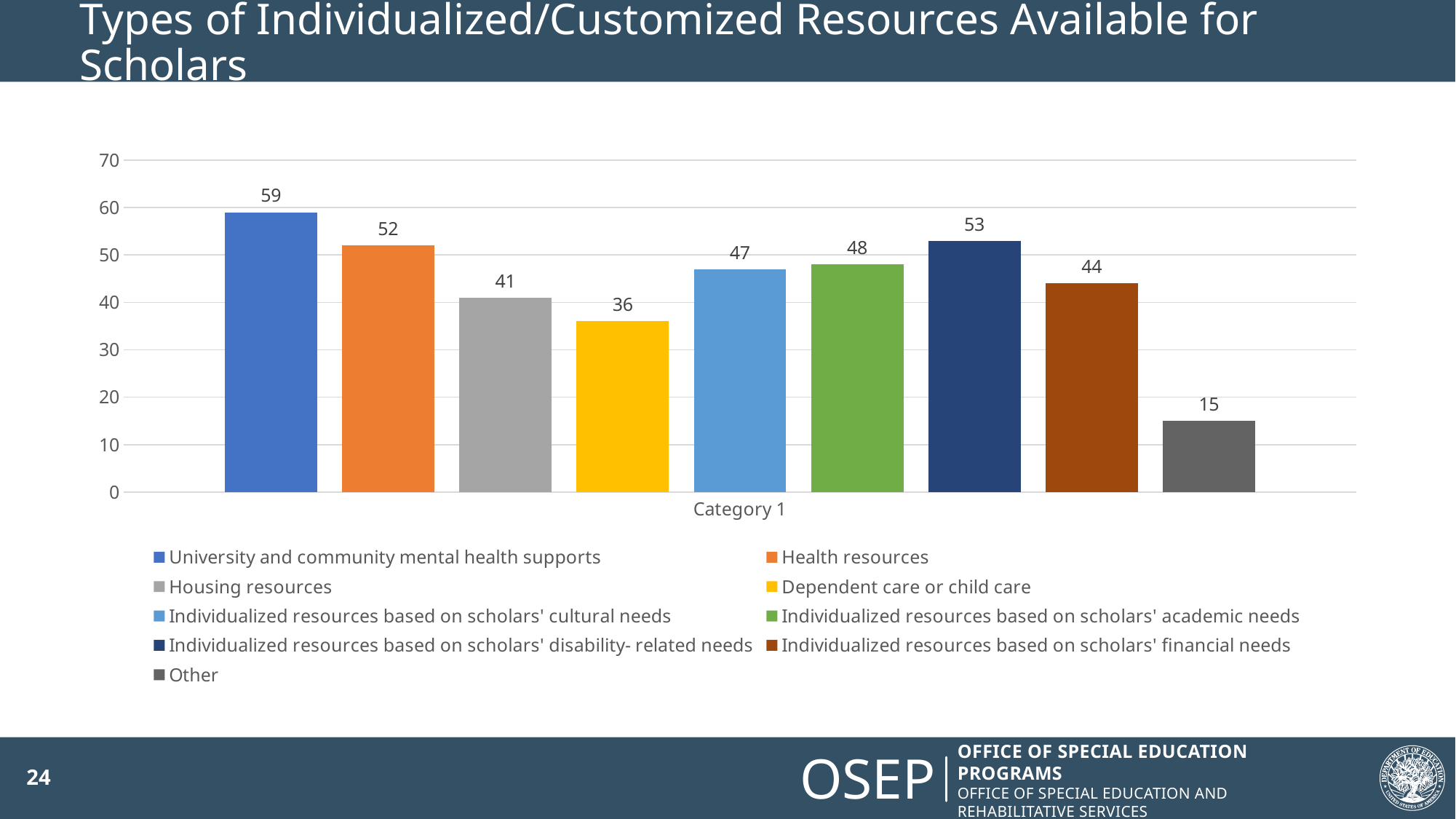
What is the value for University and community mental health supports? 59 Is the value for Individualized resources based on scholars' cultural needs greater or less than 40? greater What kind of chart is shown on the slide? bar chart What is the label on the x axis under the bars? Category 1 How many series does the legend list? 9 Which series has the lowest value? Other What is the difference between Health resources and Housing resources? 11 Which series has the highest value? University and community mental health supports What is the value for Individualized resources based on scholars' financial needs? 44 Which is larger: Individualized resources based on scholars' disability- related needs or Individualized resources based on scholars' academic needs? Individualized resources based on scholars' disability- related needs What colour is the bar for Other? dark gray What is the value for Dependent care or child care? 36